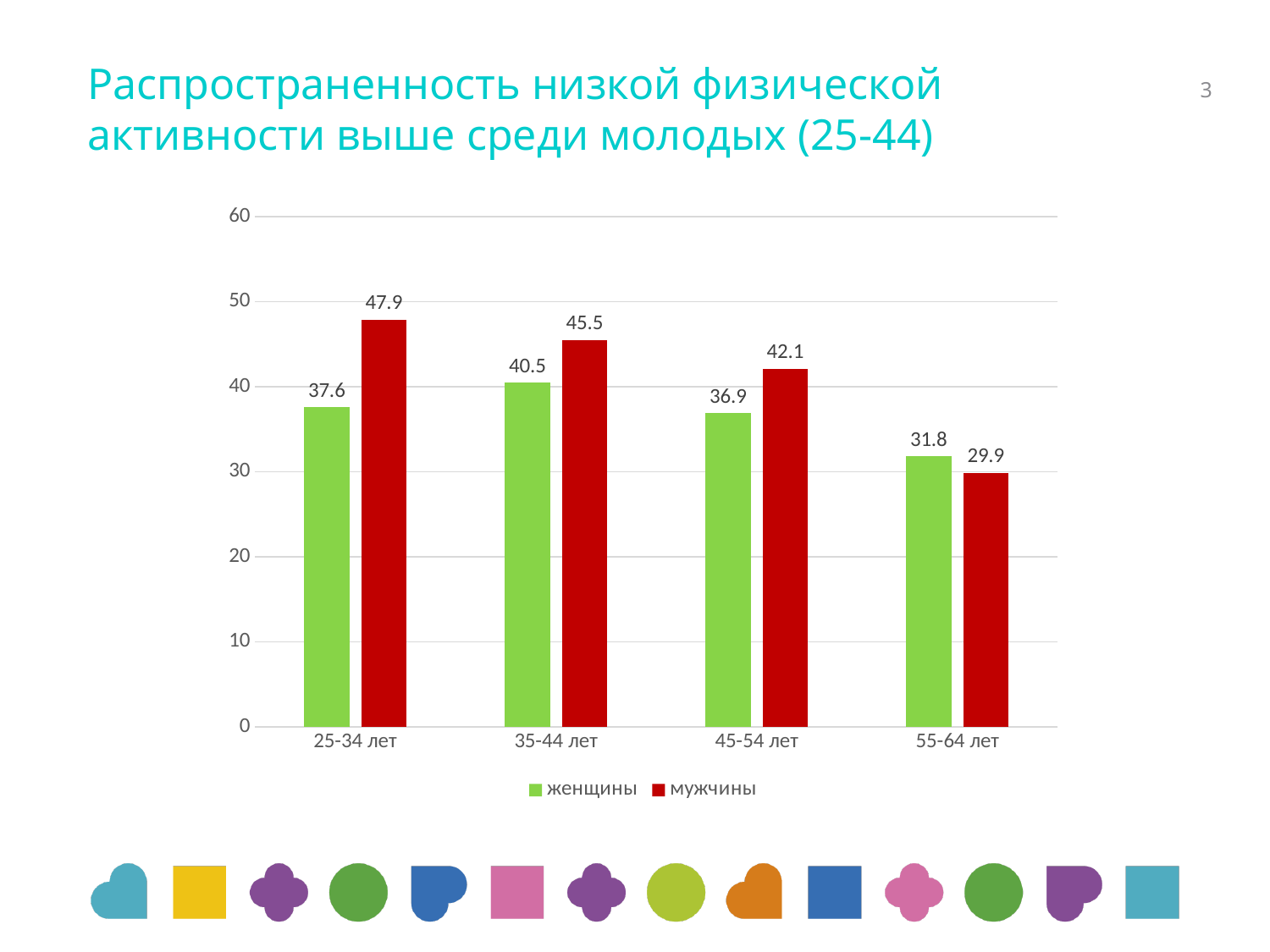
Which age group has the lowest value for женщины? 55-64 лет How many series does the legend list? 2 What is the value for женщины in the 35-44 лет age group? 40.5 Do the values for мужчины rise or fall from 25-34 лет to 55-64 лет? fall What is the value for мужчины in the 25-34 лет age group? 47.9 What is the value for женщины in the 55-64 лет age group? 31.8 What is the difference between мужчины and женщины in the 25-34 лет age group? 10.3 Which age group has the highest value for мужчины? 25-34 лет Is the value for мужчины in the 45-54 лет age group greater or less than 40? greater In the 55-64 лет age group, which is larger: женщины or мужчины? женщины What kind of chart is shown on the slide? bar chart How many age groups are shown on the x axis? 4